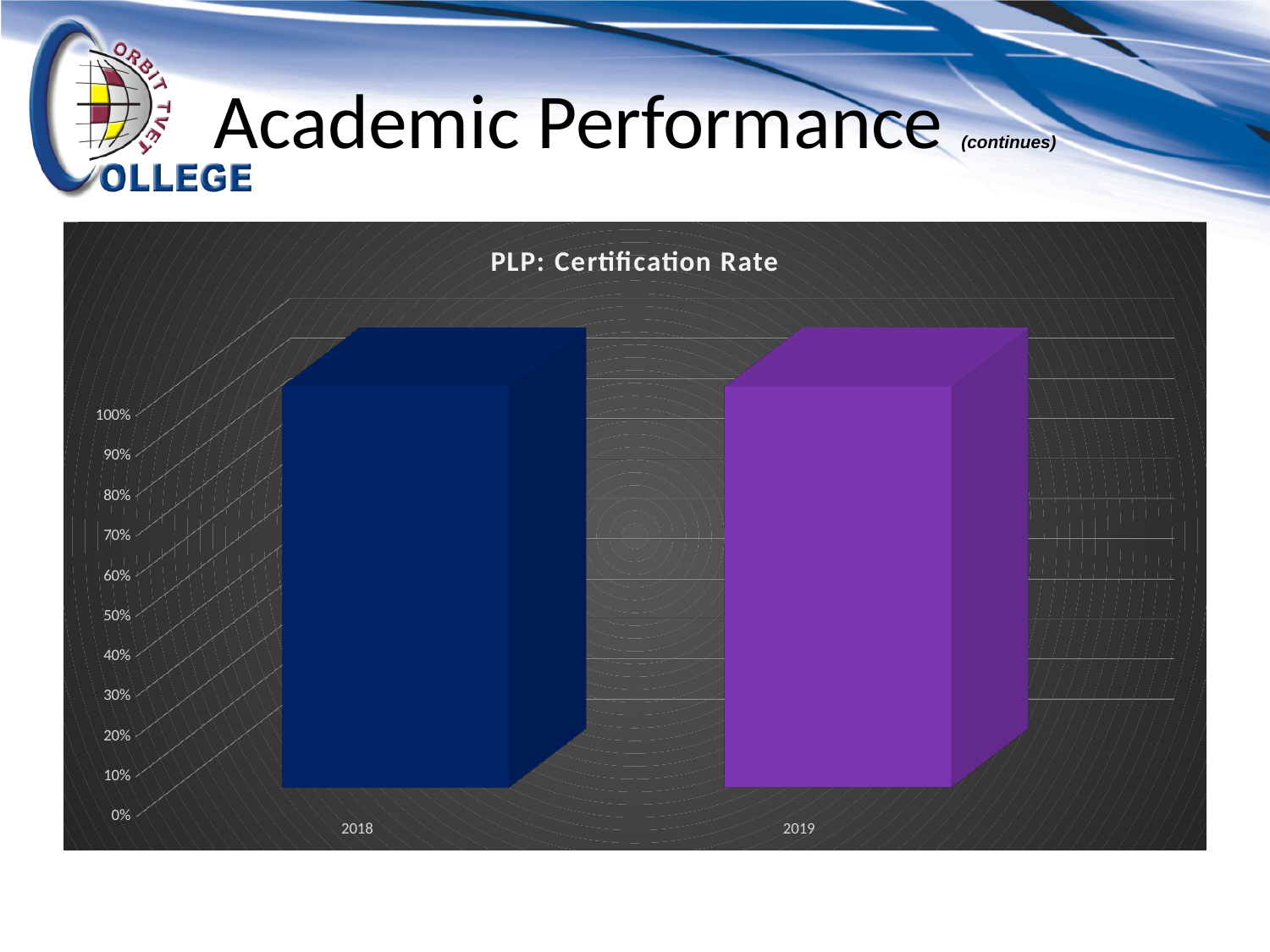
What is the title of the chart? PLP: Certification Rate Which years are shown on the x axis of the chart? 2018 and 2019 Is the certification rate for 2019 greater or less than 30%? greater Is the certification rate for 2019 greater or less than 50%? greater What kind of chart is shown on the slide? bar chart How many categories (years) are plotted on the chart? 2